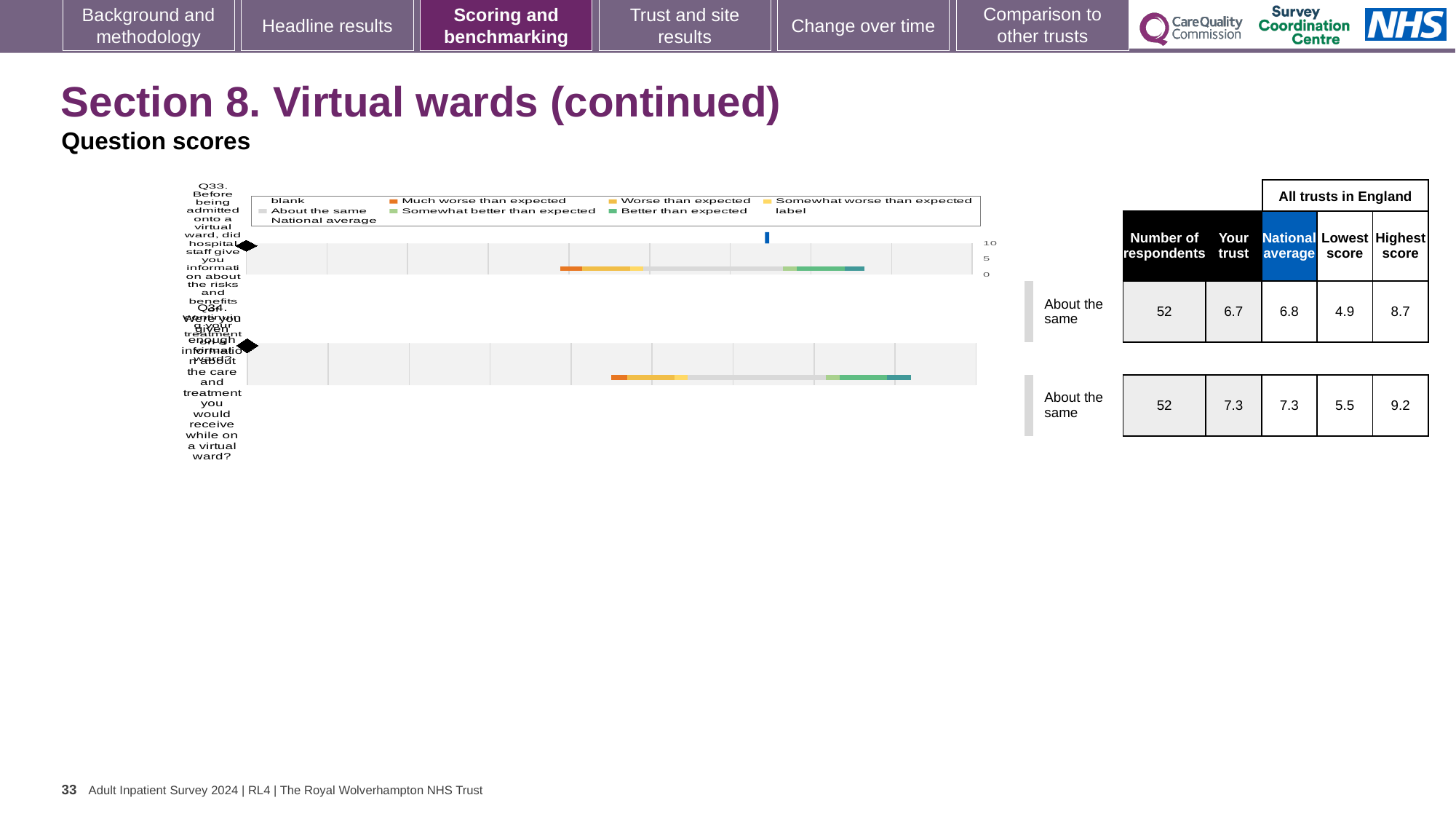
Which legend entry is shown in grey? About the same What is the highest score among all trusts in England for Q34? 9.2 How many question bars are plotted in the chart? 2 What kind of chart is shown on the slide? bar chart What is the 'Your trust' score for Q34? 7.3 What is the national average for Q33? 6.8 How many respondents answered Q34? 52 What is the 'Your trust' score for Q33? 6.7 What is the lowest score among all trusts in England for Q33? 4.9 Which colour does the legend use for 'Much worse than expected'? orange What is the difference between the 'Your trust' scores for Q34 and Q33? 0.6 Which question has the higher 'Your trust' score, Q33 or Q34? Q34